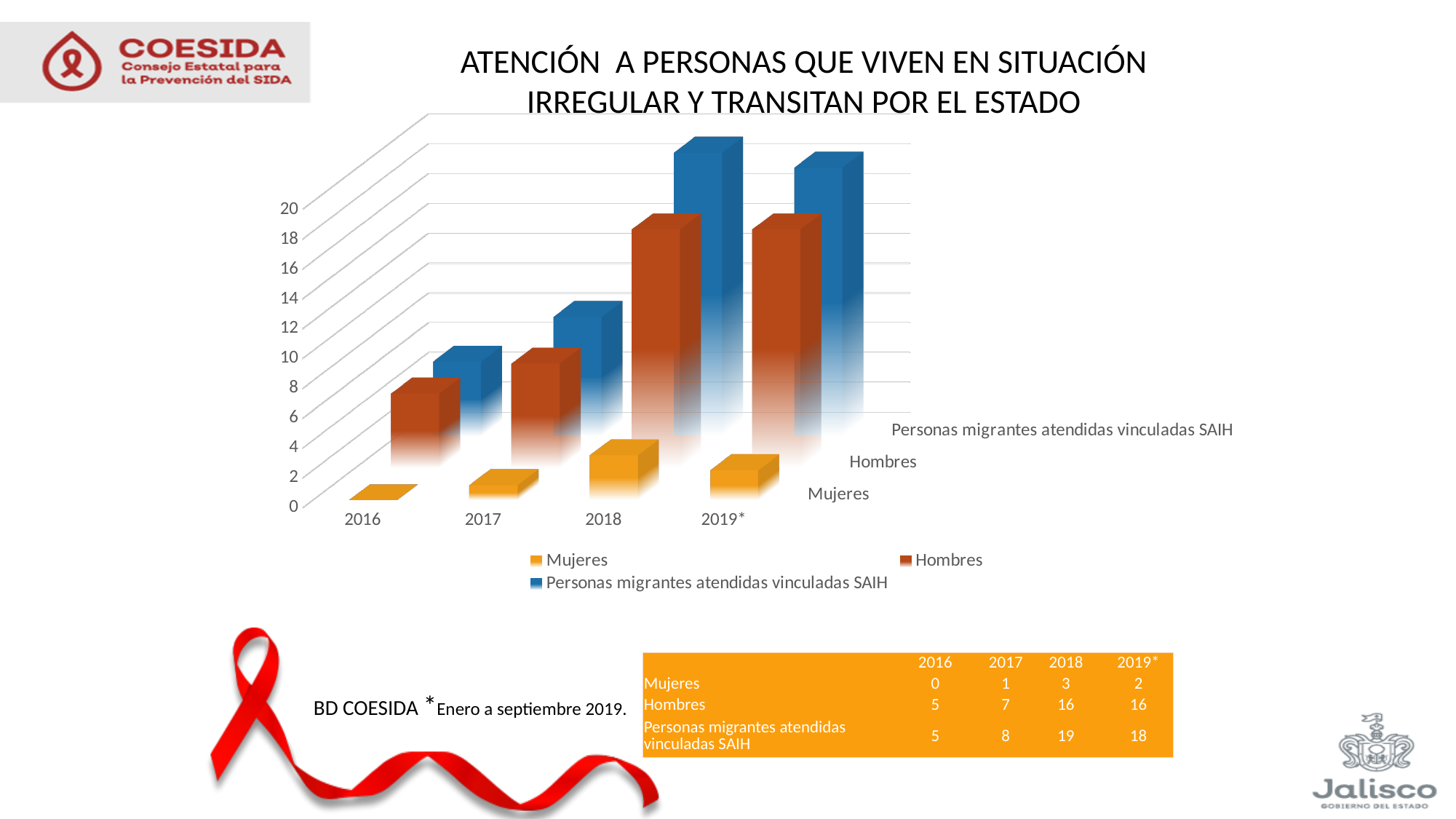
What is the value for Hombres in 2018? 16 What is the value for Personas migrantes atendidas vinculadas SAIH in 2019*? 18 How many years are shown on the x axis of the chart? 4 What is the value for Mujeres in 2017? 1 What is the difference between the Hombres values for 2018 and 2017? 9 What kind of chart is shown on the slide? bar chart In which year is the value for Personas migrantes atendidas vinculadas SAIH highest? 2018 Which colour represents Mujeres in the chart? yellow/orange Is the value for Personas migrantes atendidas vinculadas SAIH in 2017 greater or less than 10? less Which is larger, the Mujeres value for 2018 or for 2019*? 2018 How many series does the chart legend list? 3 In which year is the value for Mujeres lowest? 2016